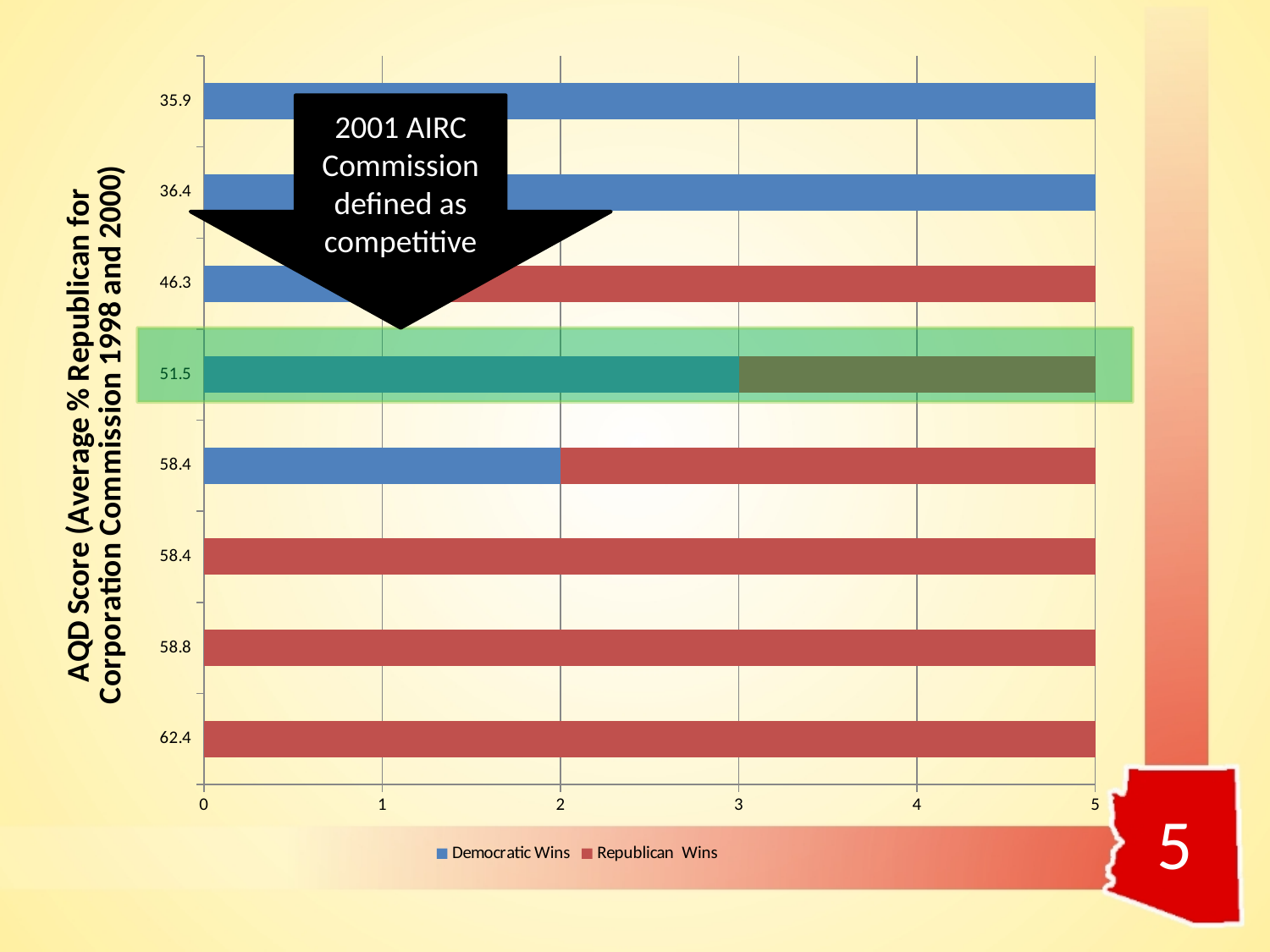
How many Republican Wins are shown for the AQD score of 62.4? 5 For the upper of the two 58.4 bars, how many Democratic Wins are shown? 2 How many series does the legend list? 2 For the AQD score of 51.5, what is the difference between Democratic Wins and Republican Wins? 1 What kind of chart is shown on the slide? bar chart How many Democratic Wins are shown for the AQD score of 51.5? 3 How many Democratic Wins are shown for the AQD score of 35.9? 5 For the AQD score of 51.5, which series has the larger value, Democratic Wins or Republican Wins? Democratic Wins What is the total number of wins in the stacked bar for the AQD score of 51.5? 5 What text appears in the black arrow callout on the chart? 2001 AIRC Commission defined as competitive How many AQD score categories are plotted on the vertical axis? 8